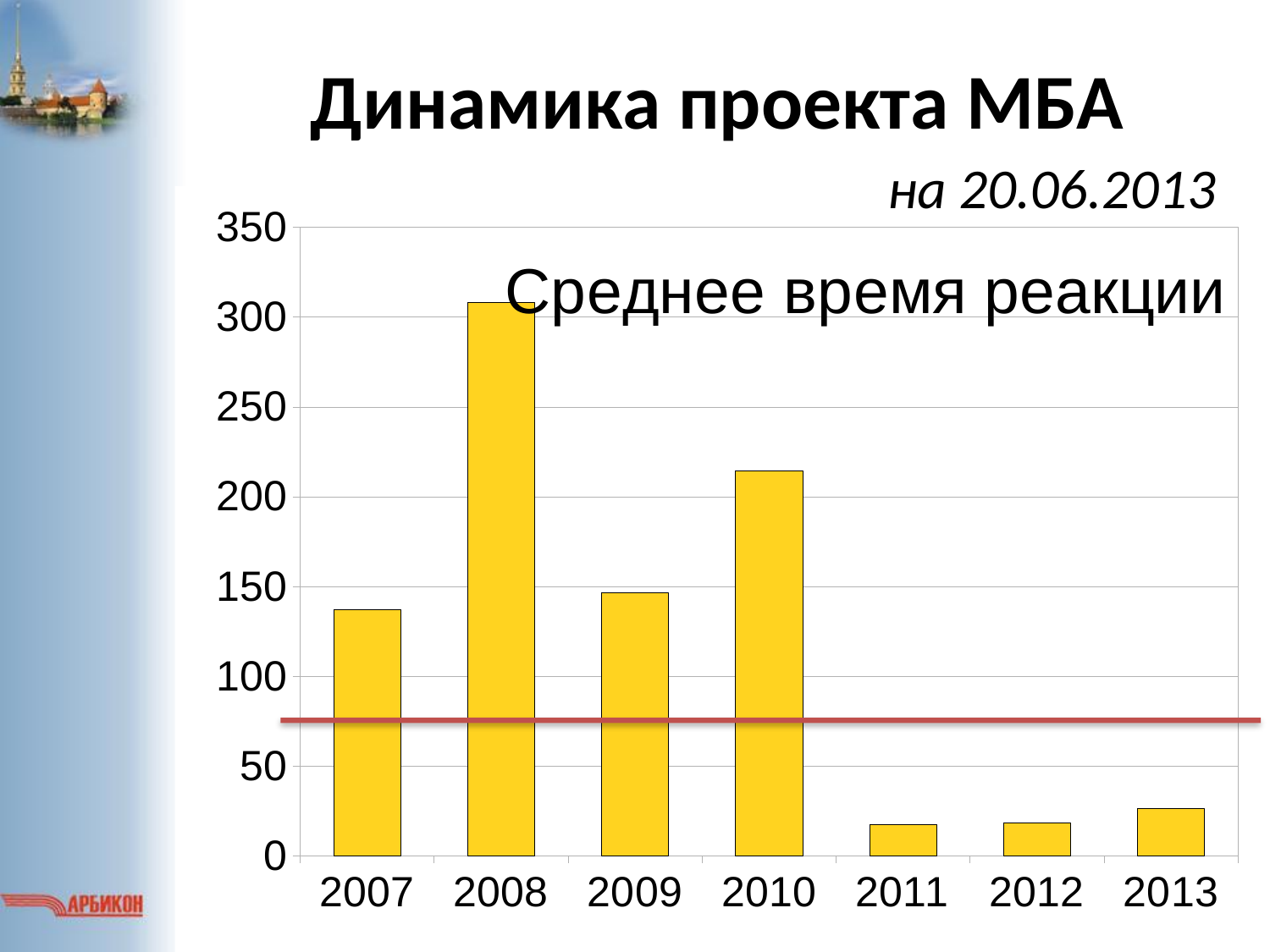
Is the value for 2007 greater or less than 150? less Is the value for 2008 greater or less than 300? greater What is the title printed inside the chart area? Среднее время реакции What kind of chart is shown on the slide? bar chart Which is larger, the value for 2010 or the value for 2009? 2010 Which year has the highest bar in the chart? 2008 How many years are shown on the x axis of the chart? 7 Is the value for 2009 greater or less than 100? greater Do the values rise or fall from 2010 to 2011? fall Which is larger, the value for 2007 or the value for 2013? 2007